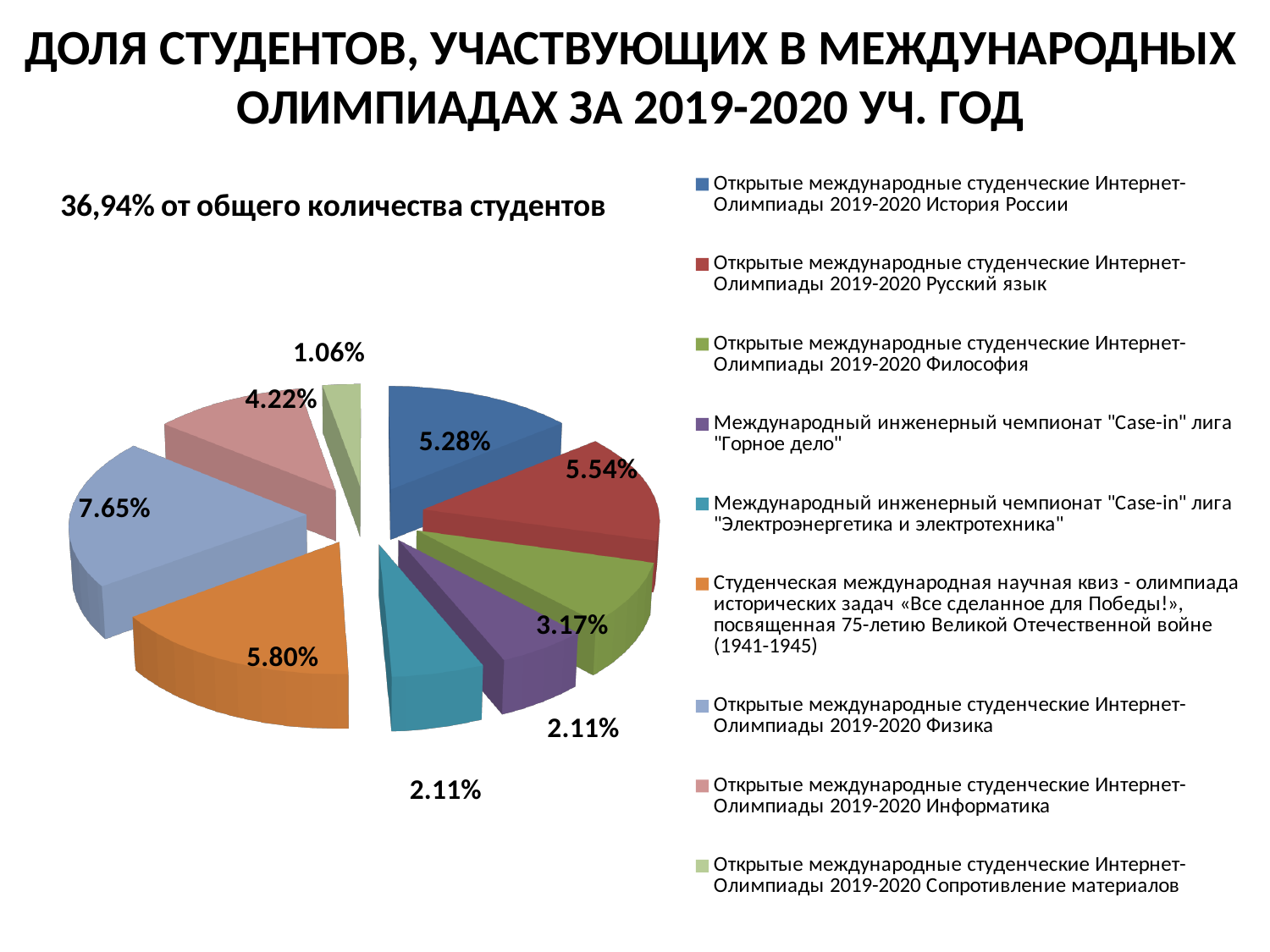
Which is larger: the value for История России or the value for Русский язык? Русский язык What is the difference between the value for Физика and the value for Информатика? 3.43% What percentage of the total number of students is stated in the chart subtitle? 36,94% How many slices does the pie chart have? 9 Which category has the largest share of the pie? Открытые международные студенческие Интернет-Олимпиады 2019-2020 Физика What is the value for Открытые международные студенческие Интернет-Олимпиады 2019-2020 Философия? 3.17% What is the value for Открытые международные студенческие Интернет-Олимпиады 2019-2020 Физика? 7.65% What is the value for Открытые международные студенческие Интернет-Олимпиады 2019-2020 Русский язык? 5.54% What kind of chart is shown on the slide? Pie chart Which category has the smallest share of the pie? Открытые международные студенческие Интернет-Олимпиады 2019-2020 Сопротивление материалов What is the value for Открытые международные студенческие Интернет-Олимпиады 2019-2020 Сопротивление материалов? 1.06% What is the value for Студенческая международная научная квиз - олимпиада исторических задач «Все сделанное для Победы!»? 5.80%